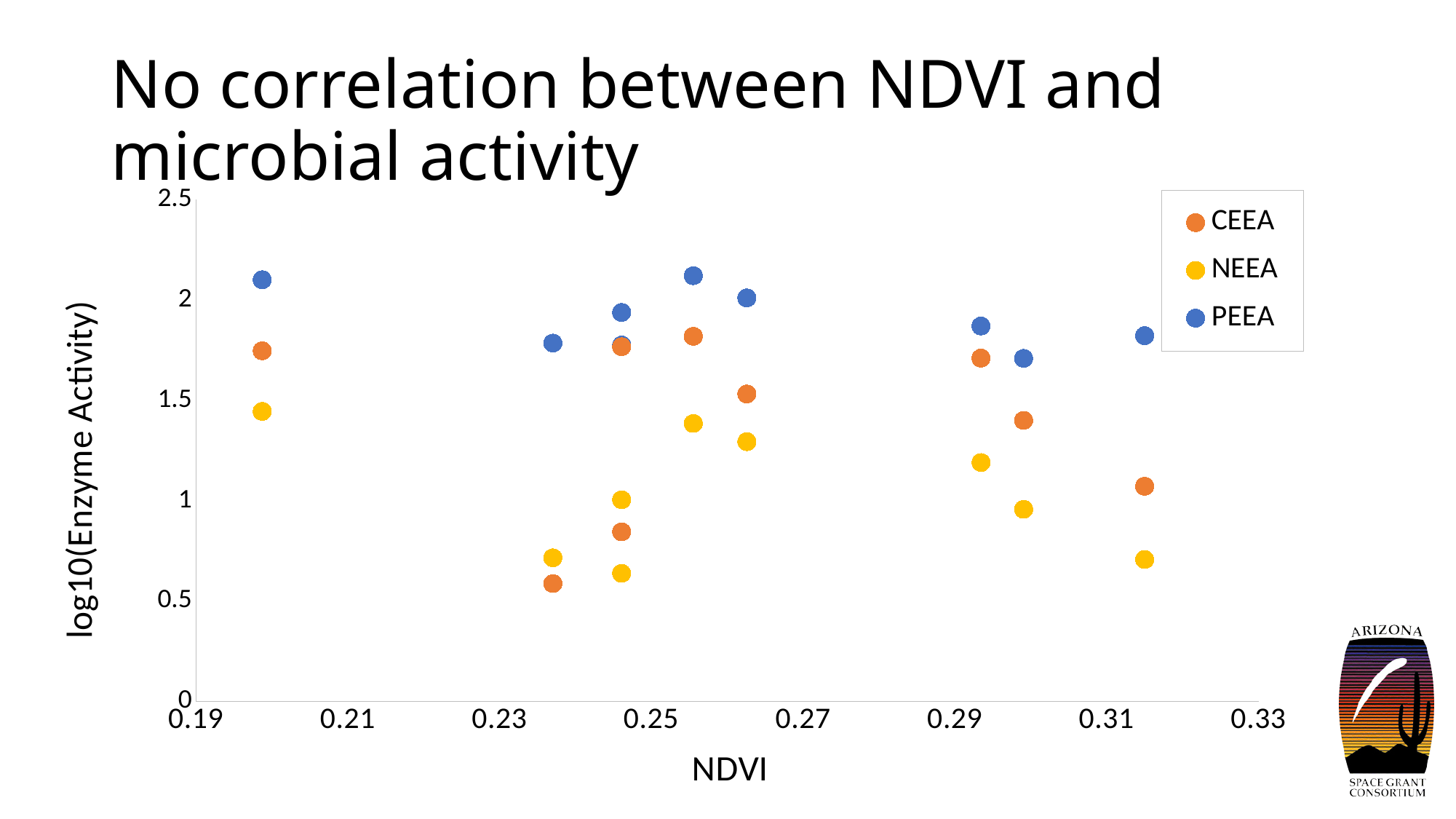
How many series does the legend list? 3 Is the CEEA value at the highest NDVI (about 0.315) greater or less than 1.5? less What kind of chart is shown on the slide? scatter chart Which series has the highest values overall across the NDVI range? PEEA Is the PEEA value at the lowest NDVI (about 0.20) greater or less than 2? greater Is the NEEA value at the lowest NDVI (about 0.20) greater or less than 1.5? less What is the label of the y axis? log10(Enzyme Activity) At the lowest NDVI (about 0.20), which series has the larger value, PEEA or NEEA? PEEA Do the PEEA values show a clear rising or falling trend as NDVI increases? no clear trend What are the three series named in the legend? CEEA, NEEA, PEEA